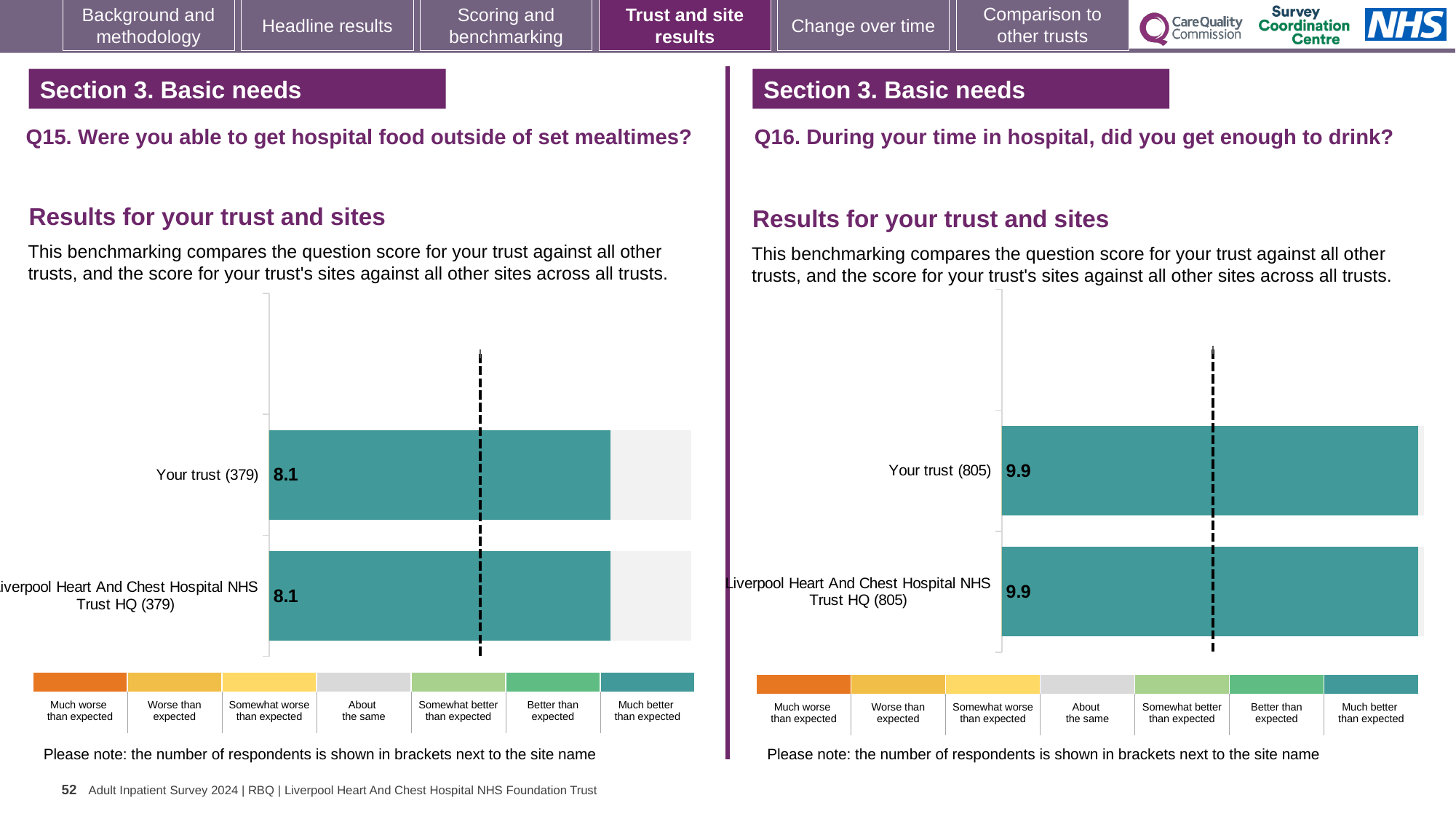
How many bars are plotted in the Q15 chart on the left? 2 In the Q15 chart on the left, how many respondents are shown in brackets for Your trust? 379 In the Q16 chart on the right, what is the score for Your trust? 9.9 In the Q16 chart on the right, what is the difference between the score for Your trust and the score for Liverpool Heart And Chest Hospital NHS Trust HQ? 0 In the Q15 chart on the left, what is the score for Liverpool Heart And Chest Hospital NHS Trust HQ? 8.1 How many bars are plotted in the Q16 chart on the right? 2 In the Q16 chart on the right, what is the score for Liverpool Heart And Chest Hospital NHS Trust HQ? 9.9 In the Q16 chart on the right, how many respondents are shown in brackets for Liverpool Heart And Chest Hospital NHS Trust HQ? 805 What kind of chart is the Q16 chart on the right? Bar chart Is the score for Your trust in the Q16 chart on the right larger or smaller than the score for Your trust in the Q15 chart on the left? Larger In the Q15 chart on the left, what is the score for Your trust? 8.1 In the Q15 chart on the left, what is the difference between the score for Your trust and the score for Liverpool Heart And Chest Hospital NHS Trust HQ? 0